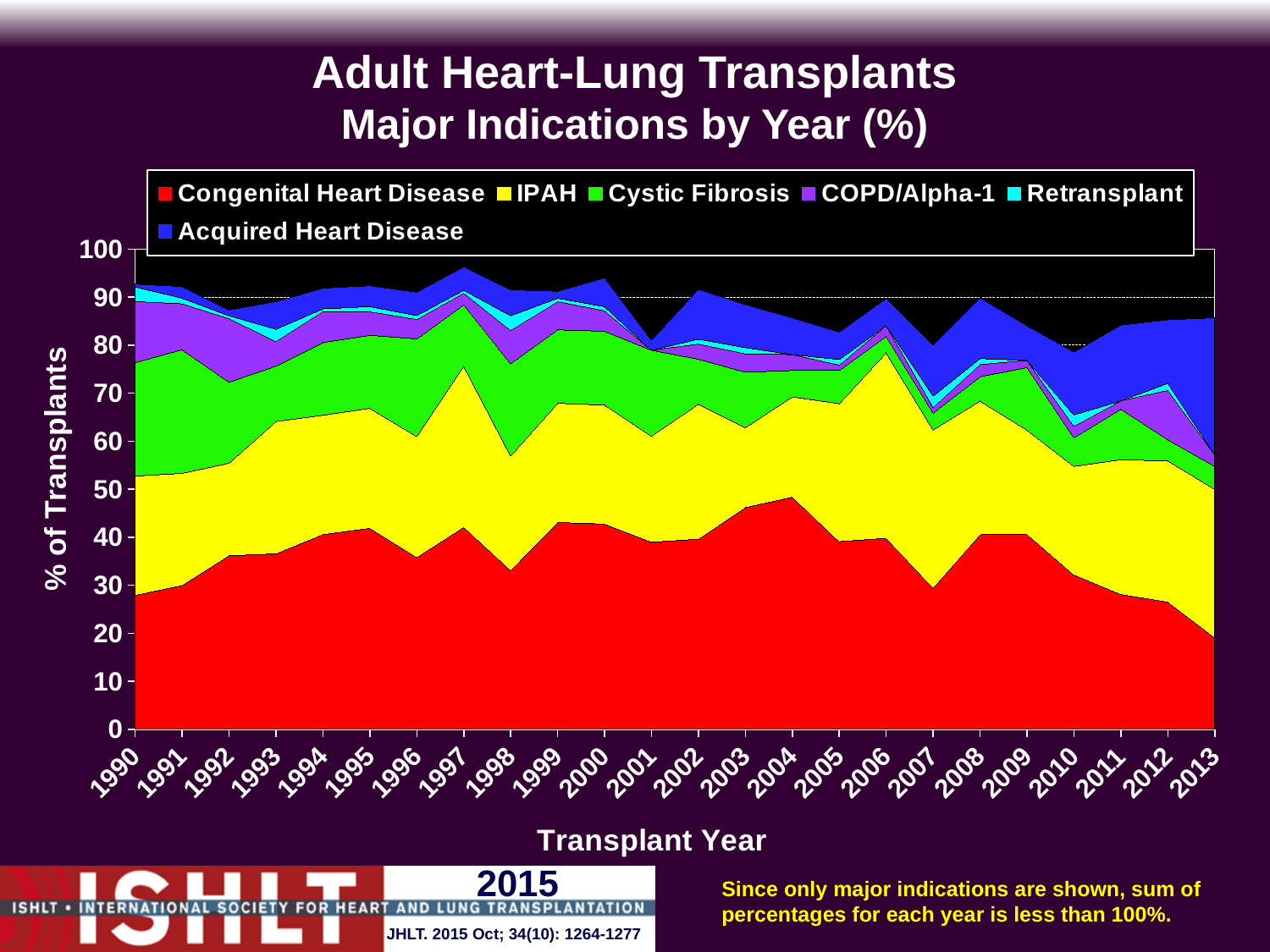
How many transplant years are plotted along the x axis? 24 What is the label of the y axis? % of Transplants Which is larger, the Congenital Heart Disease share in 1990 or in 2013? 1990 In which year is the Congenital Heart Disease share lowest? 2013 Is the value for Congenital Heart Disease in 2013 greater or less than 30? less How many series does the legend list? 6 What is the title of the chart? Adult Heart-Lung Transplants Major Indications by Year (%) Does the Congenital Heart Disease share rise or fall from 2004 to 2013? Fall What kind of chart is shown on the slide? Stacked area chart Is the value for Congenital Heart Disease in 2004 greater or less than 40? greater